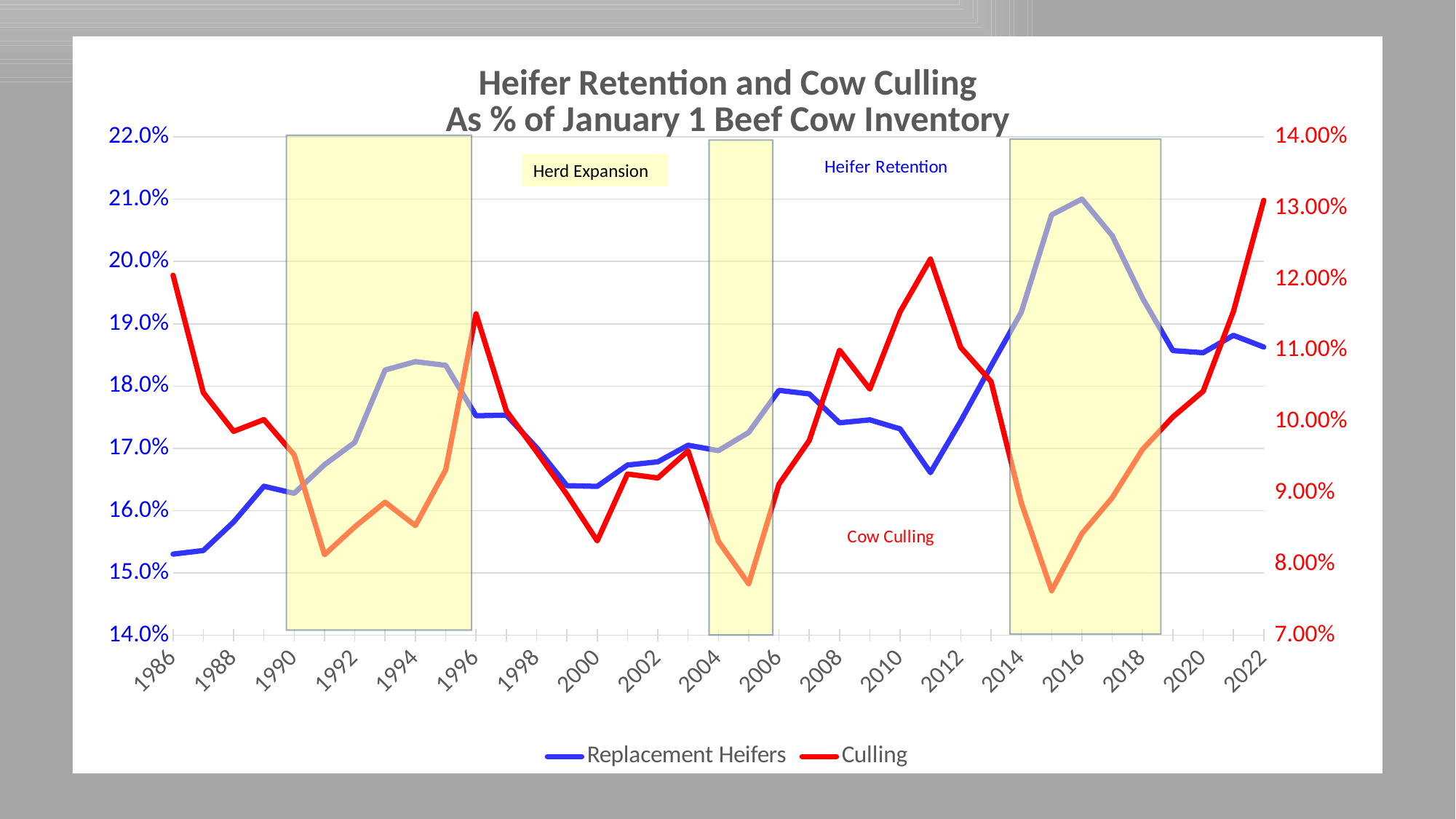
Which is higher for the Culling series, the value in 2022 or the value in 2011? 2022 How many series does the legend list? 2 What is the title of the chart? Heifer Retention and Cow Culling As % of January 1 Beef Cow Inventory What are the two series named in the legend? Replacement Heifers and Culling Is the Replacement Heifers value for 1986 greater or less than 16.0%? less In which year does the Replacement Heifers series reach its highest value? 2016 In which year does the Culling series reach its highest value? 2022 Is the Culling value for 2015 greater or less than 8.00%? less Is the Culling value for 2022 greater or less than 12.00%? greater Does the Replacement Heifers series rise or fall between 2011 and 2016? rise What kind of chart is shown on the slide? line chart